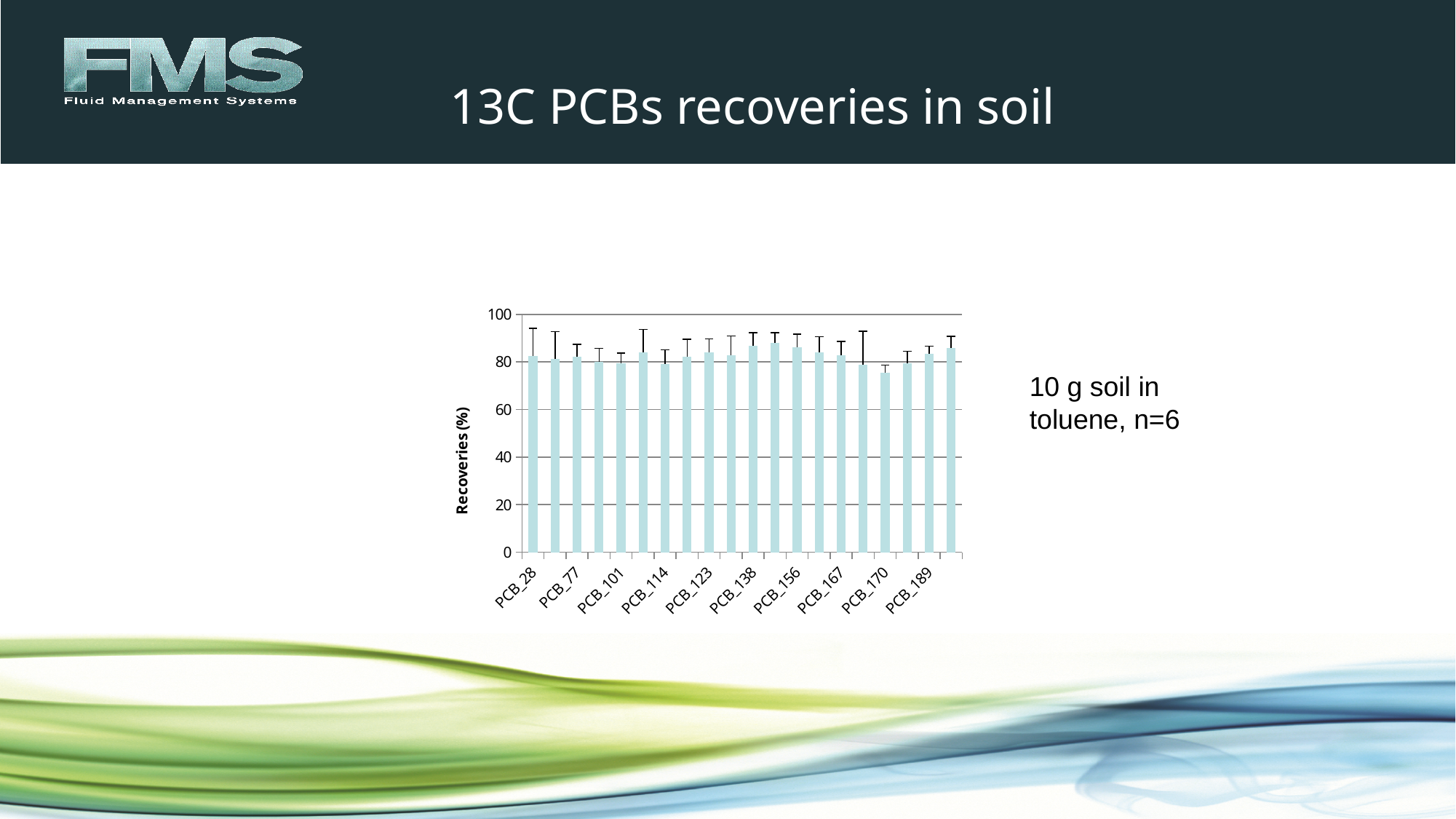
Is the recovery value for PCB_156 greater or less than 80? greater Which labelled PCB congener has the lowest recovery in the chart? PCB_170 Is the recovery value for PCB_28 greater or less than 60? greater Which has the higher recovery, PCB_170 or PCB_189? PCB_189 Is the recovery value for PCB_189 greater or less than 100? less How many bars are plotted in the chart? 20 What kind of chart is shown on the slide? bar chart What is the title of the slide containing the chart? 13C PCBs recoveries in soil What is the label of the vertical axis of the chart? Recoveries (%) Which has the higher recovery, PCB_138 or PCB_170? PCB_138